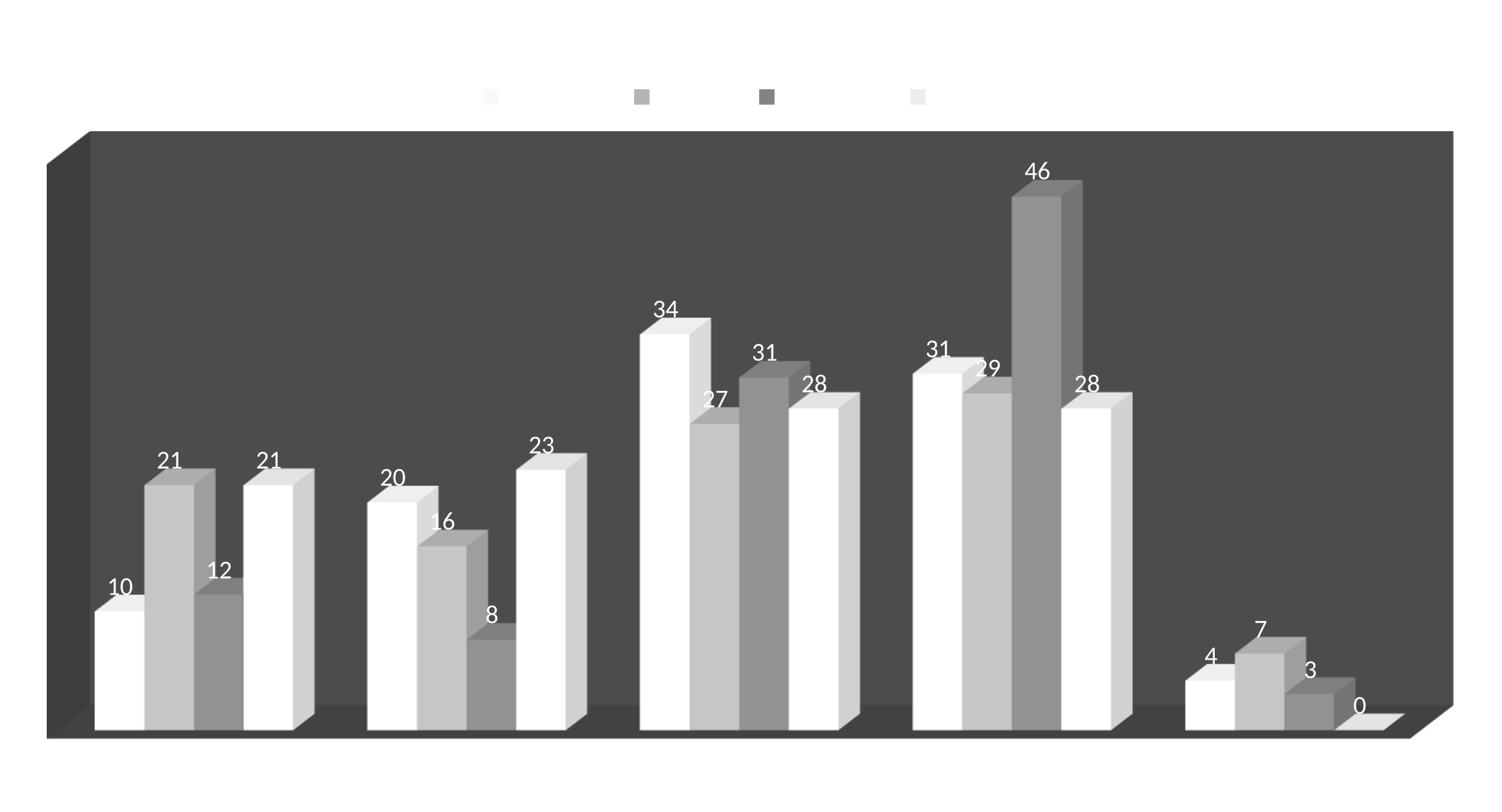
How many series does the legend list? 4 What is the value of the first (leftmost) bar in the leftmost group? 10 What kind of chart is shown on the slide? bar chart In the fourth group from the left, how much larger is the third bar (46) than the first bar (31)? 15 In the second group from the left, which is larger: the first bar or the fourth bar? the fourth bar How many groups of bars are plotted along the x axis? 5 What is the value of the last bar in the rightmost group? 0 What is the highest data label value shown on the chart? 46 In the third group from the left, what is the difference between the first bar (34) and the second bar (27)? 7 In the second group from the left, which bar has the highest value? the fourth bar (23) What is the value of the third bar in the fourth group from the left? 46 What is the lowest data label value shown on the chart? 0